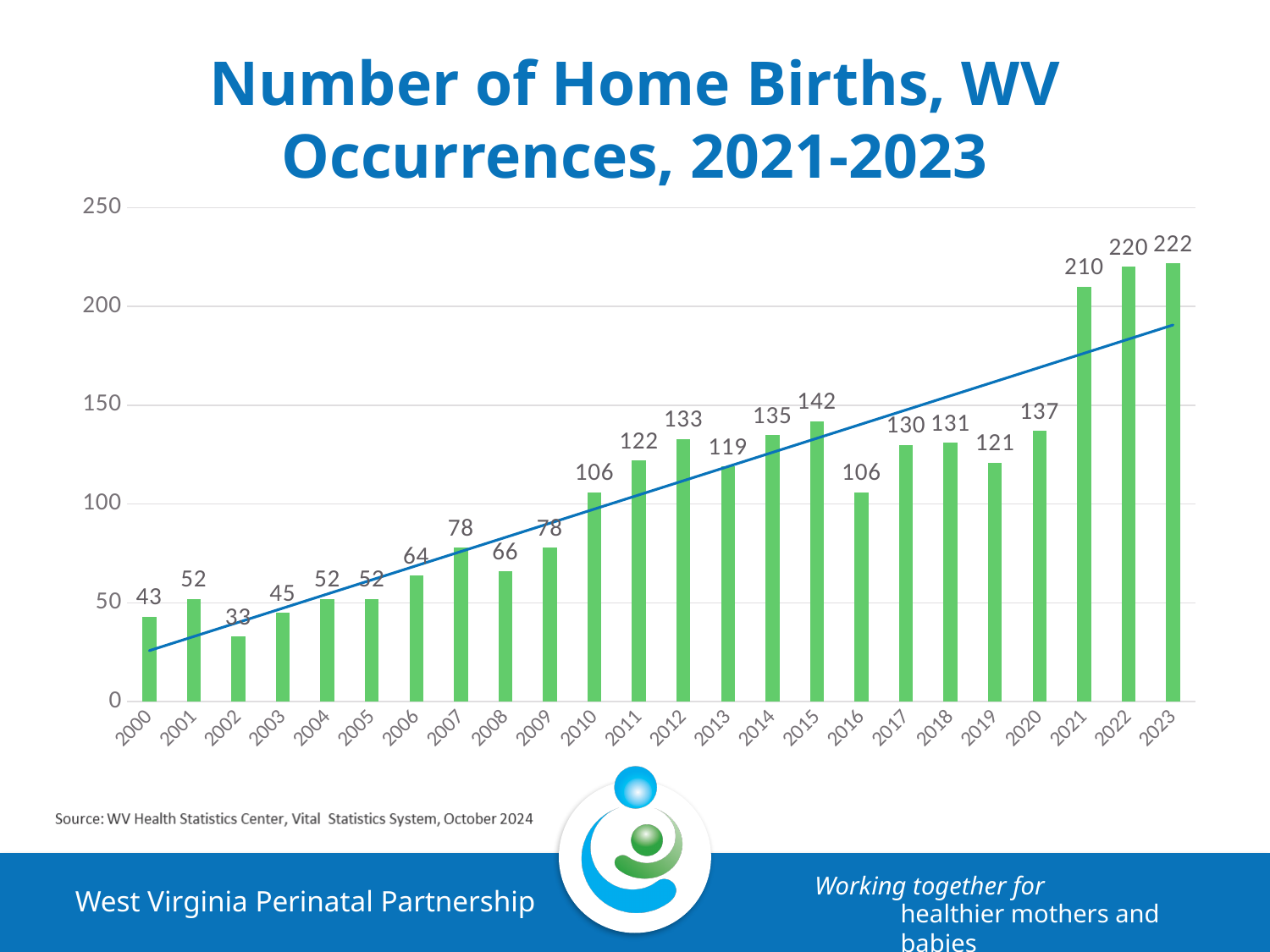
Which year has the lowest number of home births? 2002 Which year had more home births, 2015 or 2019? 2015 How many years are shown on the x axis? 24 Is the value for 2021 greater or less than 200? greater Do the number of home births generally rise or fall from 2000 to 2023? rise What is the difference between the number of home births in 2021 and in 2020? 73 What is the number of home births in 2016? 106 What kind of chart is shown on the slide? bar chart Which year has the highest number of home births? 2023 What is the number of home births in 2002? 33 What is the difference between the number of home births in 2023 and in 2000? 179 What is the number of home births in 2023? 222